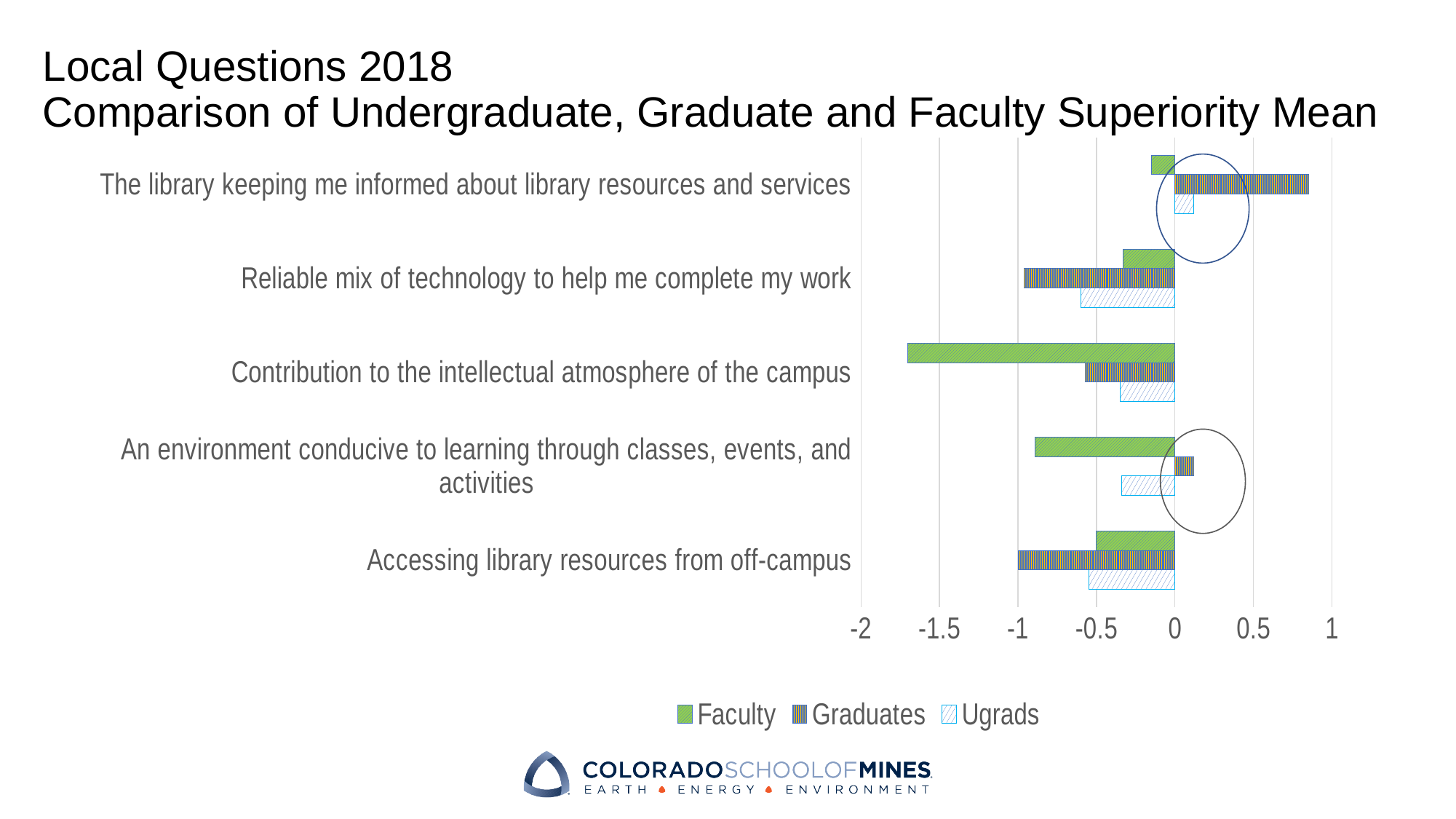
How many series does the legend list? 3 How many categories (survey questions) are plotted on the chart? 5 For 'Reliable mix of technology to help me complete my work', which is larger: the Faculty value or the Graduates value? Faculty Is the Graduates value for 'Reliable mix of technology to help me complete my work' greater or less than -0.5? less What kind of chart is shown on the slide? Bar chart Is the Graduates value for 'The library keeping me informed about library resources and services' greater or less than 0.5? greater Which series are listed in the legend? Faculty, Graduates, Ugrads Which category has the lowest Faculty value? Contribution to the intellectual atmosphere of the campus For 'An environment conducive to learning through classes, events, and activities', which is larger: the Graduates value or the Faculty value? Graduates Is the Faculty value for 'Contribution to the intellectual atmosphere of the campus' greater or less than -1.5? less Which category has the highest Graduates value? The library keeping me informed about library resources and services